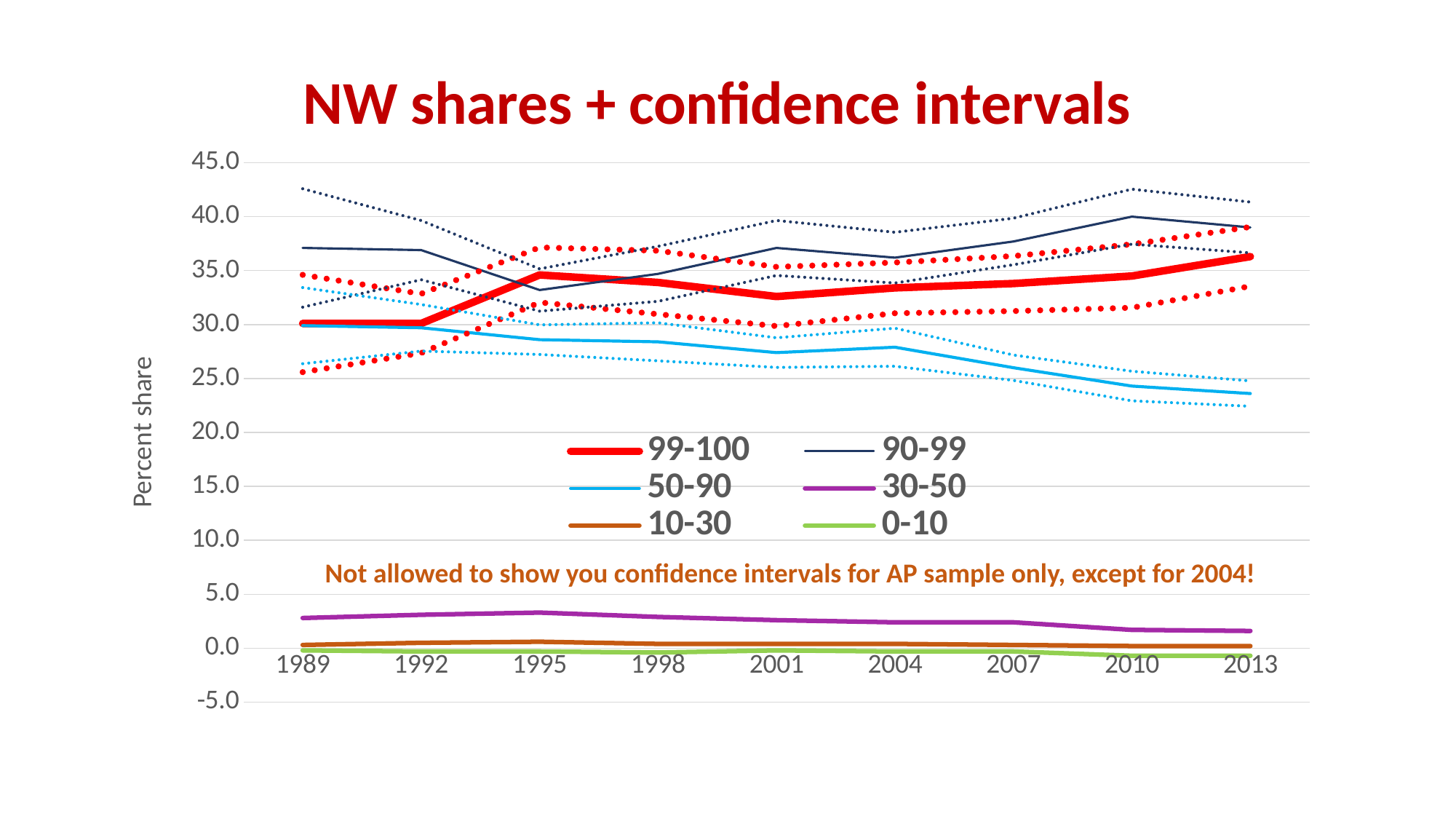
What is the label on the y axis? Percent share Is the value for the 99-100 series in 1989 greater or less than 35.0? less Which series has the lowest value in 2013? 0-10 How many series does the legend list? 6 Does the 99-100 series rise or fall from 1989 to 2013? rise What kind of chart is shown on the slide? line chart Is the value for the 50-90 series in 2013 greater or less than 25.0? less What is the title of the chart? NW shares + confidence intervals Is the value for the 99-100 series in 2013 greater or less than 30.0? greater Which series has the highest value in 1989? 90-99 How many years are shown on the x axis? 9 Does the 50-90 series rise or fall from 1989 to 2013? fall